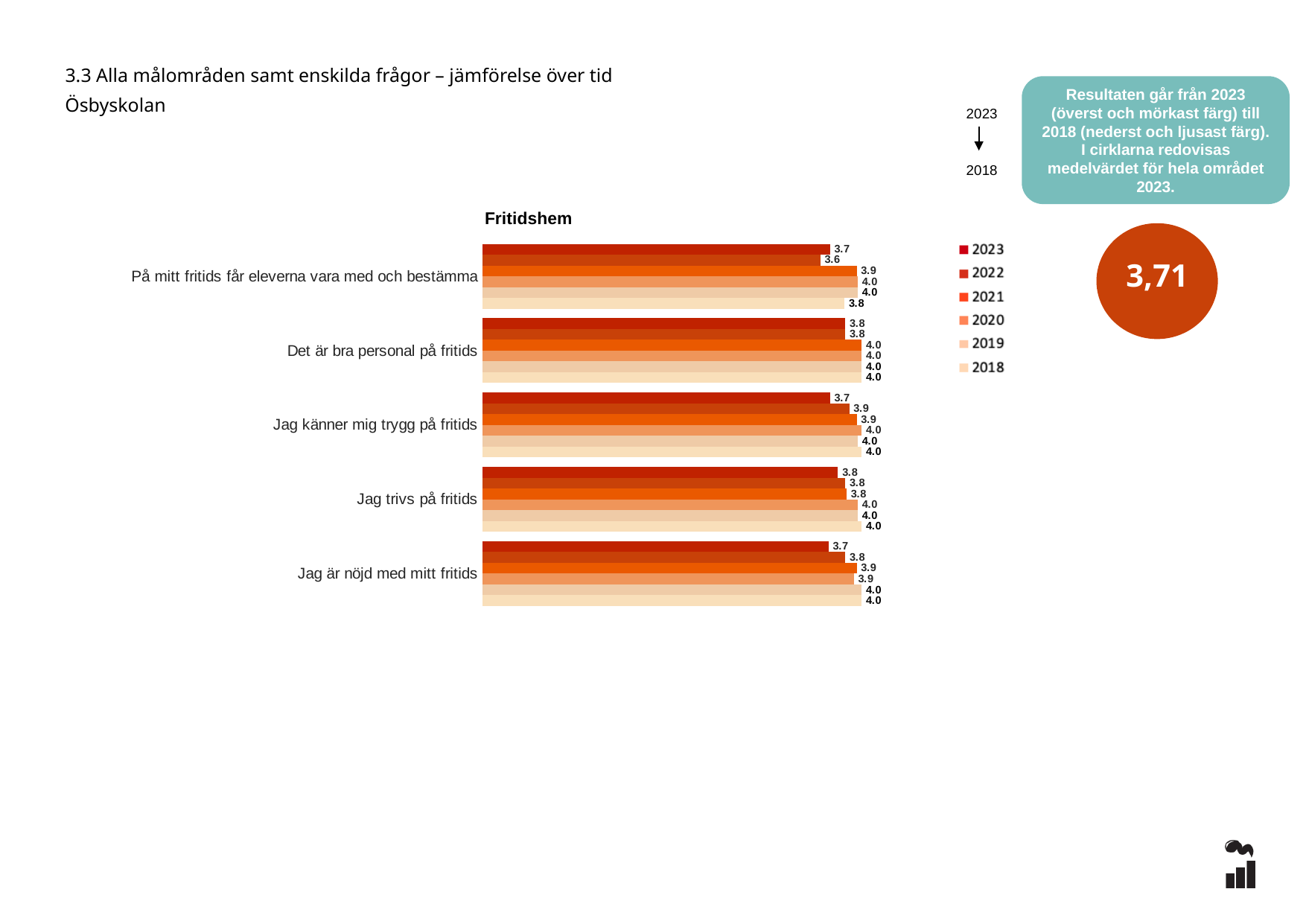
Which is larger for "Jag känner mig trygg på fritids": the 2023 value or the 2022 value? 2022 How many categories (questions) are shown in the chart? 5 What is the title of the chart? Fritidshem What is the 2021 value for "Jag trivs på fritids"? 3.8 Which year has the lowest value for "Jag är nöjd med mitt fritids"? 2023 What is the difference between the 2021 and 2022 values for "På mitt fritids får eleverna vara med och bestämma"? 0.3 What is the 2020 value for "Jag känner mig trygg på fritids"? 4.0 What is the 2018 value for "Jag är nöjd med mitt fritids"? 4.0 What is the 2022 value for "På mitt fritids får eleverna vara med och bestämma"? 3.6 What is the 2023 value for "Det är bra personal på fritids"? 3.8 What kind of chart is shown on the slide? Bar chart How many series does the legend list? 6